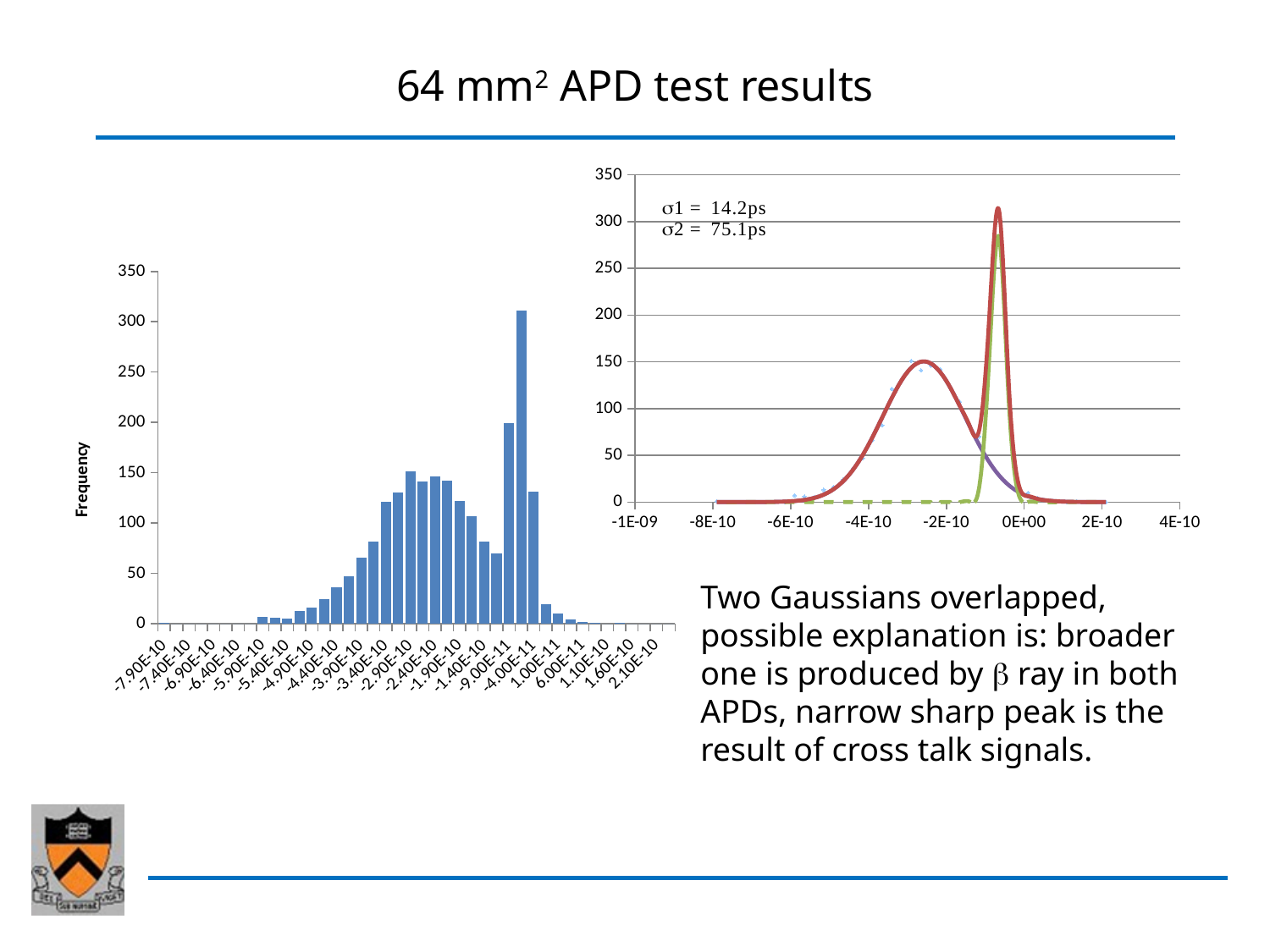
On the right chart, what value is given for σ1? 14.2ps On the right chart, is the peak of the broad Gaussian greater or less than 200? less On the right chart, what value is given for σ2? 75.1ps On the right chart, is the peak of the narrow Gaussian greater or less than 250? greater On the left chart, what is the title of the vertical axis? Frequency What kind of chart is the chart on the left of the slide? bar chart On the right chart, which peak is higher, the narrow Gaussian or the broad Gaussian? the narrow Gaussian On the left chart, is the value of the tallest bar greater or less than 350? less On the left chart, what is the first label on the horizontal axis? -7.90E-10